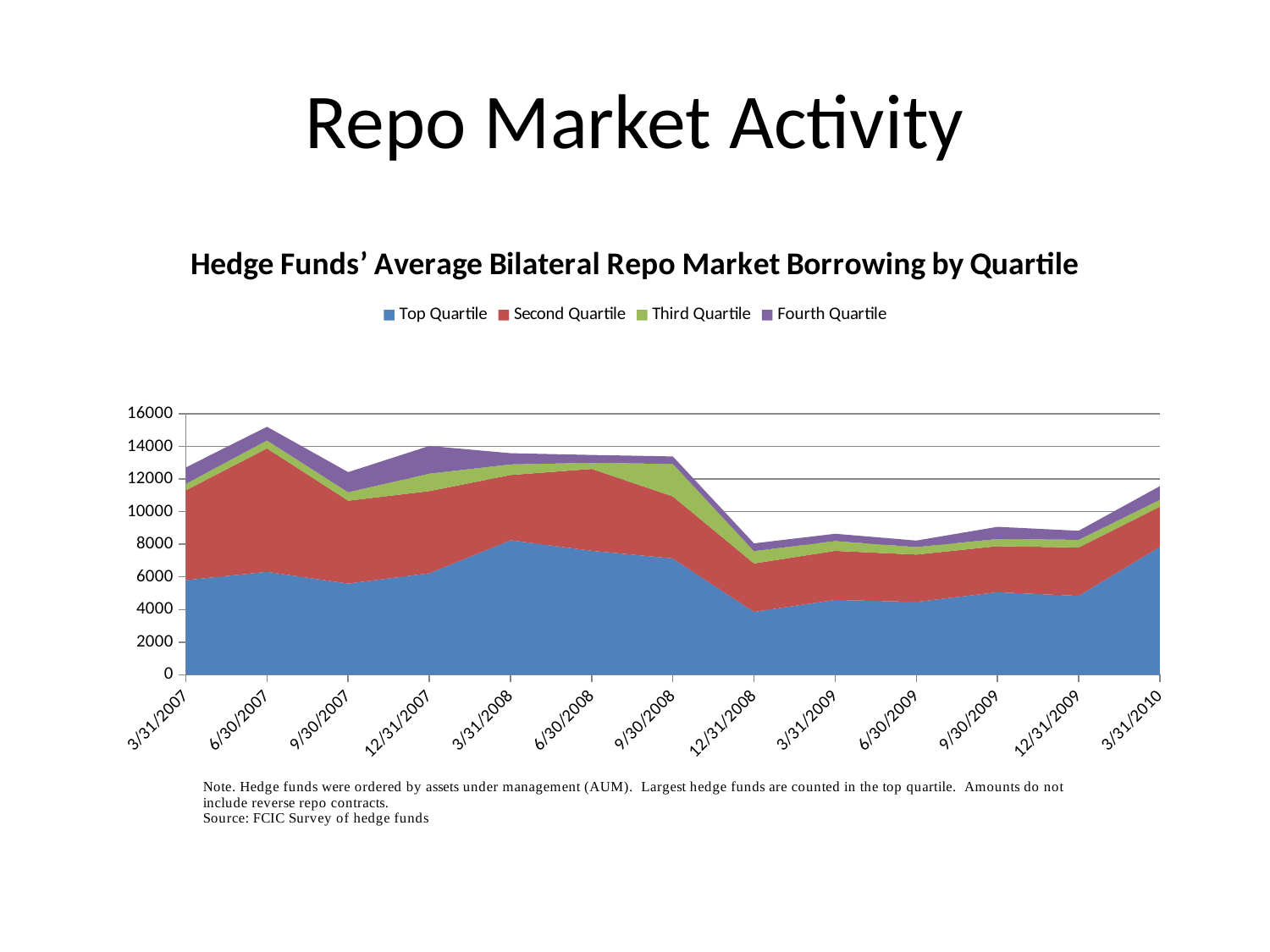
Which series is shown in blue in the legend? Top Quartile On which date is the total stacked value across all quartiles highest? 6/30/2007 Is the total stacked value on 6/30/2007 greater or less than 14000? greater Is the total stacked value on 3/31/2010 greater or less than 10000? greater Is the Top Quartile value on 12/31/2008 greater or less than 6000? less What is the title of the chart? Hedge Funds' Average Bilateral Repo Market Borrowing by Quartile How many series does the legend list? 4 What kind of chart is shown on the slide? Stacked area chart On which date is the Top Quartile value lowest? 12/31/2008 How many dates are plotted along the x axis? 13 Does the total stacked value rise or fall from 9/30/2008 to 12/31/2008? fall Which is larger, the total stacked value on 6/30/2007 or on 12/31/2008? 6/30/2007